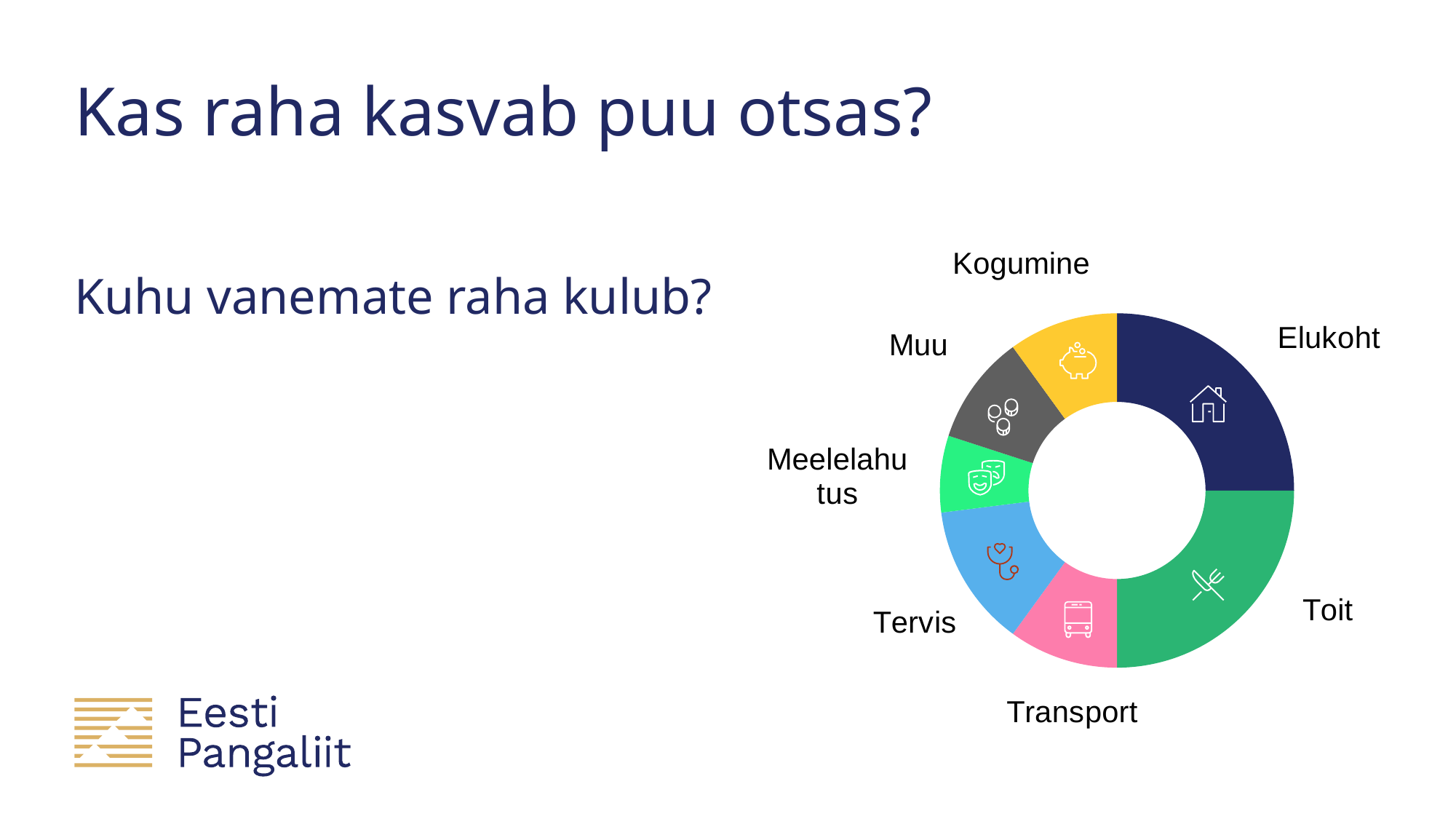
What kind of chart is shown on the slide? Pie chart (donut) Which is larger, the slice for Toit or the slice for Muu? Toit How many categories does the chart show? 7 Which is larger, the slice for Kogumine or the slice for Toit? Toit What question does the heading above the chart ask? Kuhu vanemate raha kulub? Which is larger, the slice for Elukoht or the slice for Transport? Elukoht What colour is the Toit slice of the chart? Green